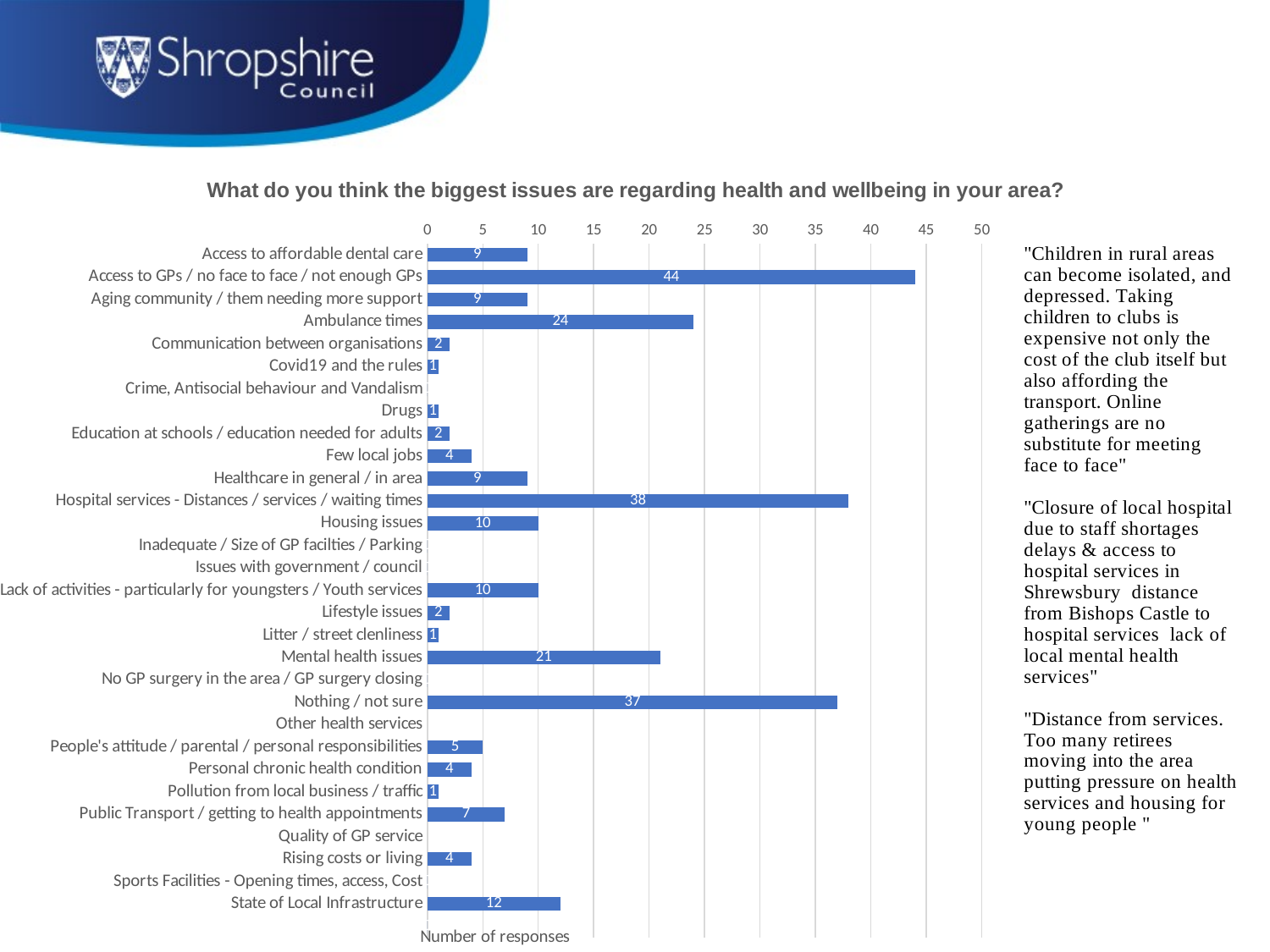
What is the label on the value axis of the chart? Number of responses Which has more responses, Nothing / not sure or Hospital services - Distances / services / waiting times? Hospital services - Distances / services / waiting times What is the number of responses for State of Local Infrastructure? 12 What type of chart is shown on the slide? Bar chart Is the value for Ambulance times greater or less than 20? greater What is the number of responses for Mental health issues? 21 What is the difference in responses between Access to GPs / no face to face / not enough GPs and Hospital services - Distances / services / waiting times? 6 How many categories are listed on the chart? 30 Which category has the highest number of responses? Access to GPs / no face to face / not enough GPs What is the number of responses for Public Transport / getting to health appointments? 7 What is the difference in responses between Ambulance times and Mental health issues? 3 What is the number of responses for Access to GPs / no face to face / not enough GPs? 44